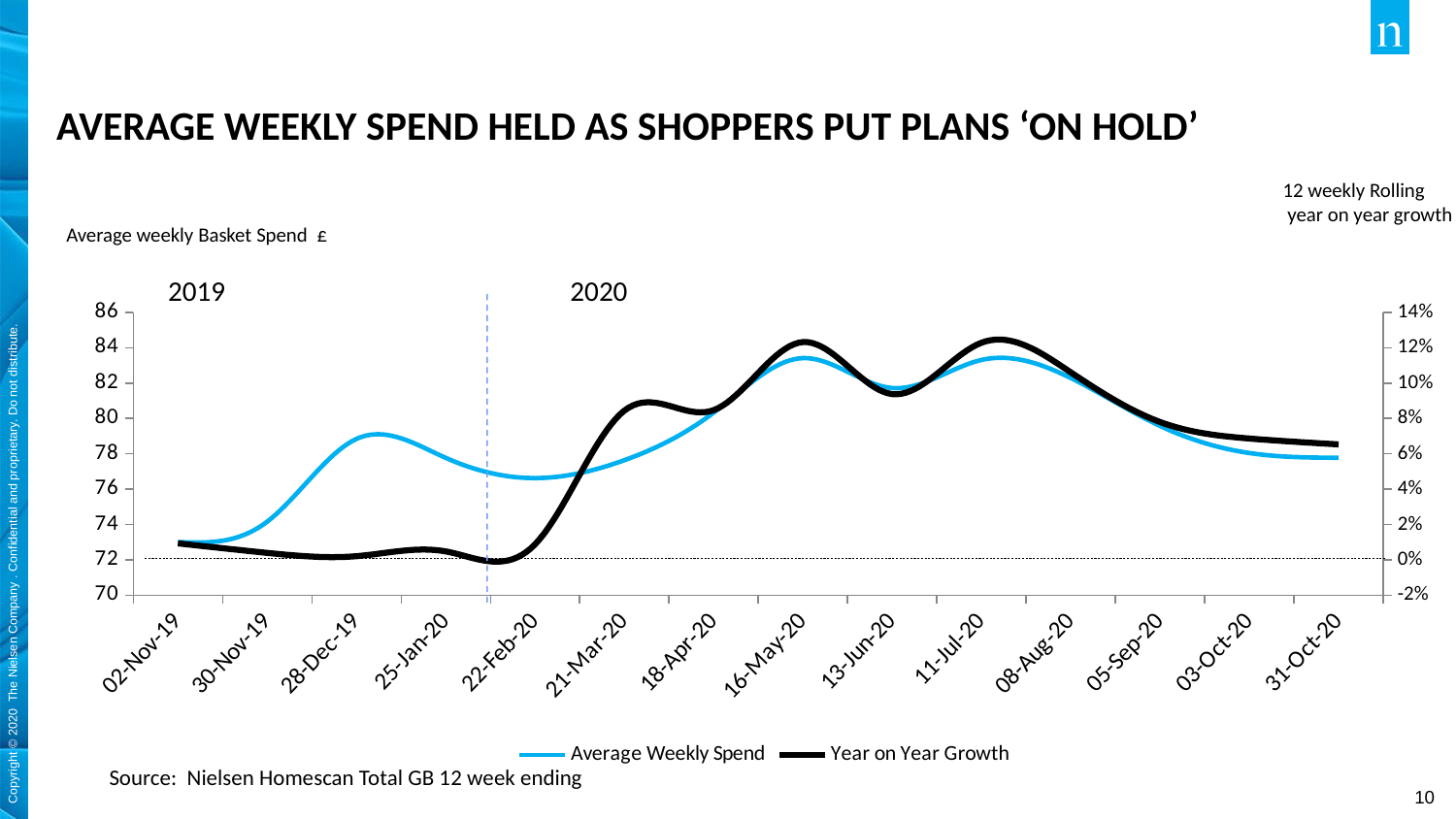
Is the Average Weekly Spend value at 28-Dec-19 greater or less than 76? greater What are the two series named in the legend? Average Weekly Spend and Year on Year Growth Is the Average Weekly Spend value at 02-Nov-19 greater or less than 74? less What kind of chart is shown on the slide? line chart How many date labels are shown on the x axis? 14 Is the Year on Year Growth value at 11-Jul-20 greater or less than 10%? greater What is the title of the slide? AVERAGE WEEKLY SPEND HELD AS SHOPPERS PUT PLANS 'ON HOLD' How many series does the legend list? 2 Does the Year on Year Growth line rise or fall between 22-Feb-20 and 16-May-20? rise Is the Average Weekly Spend higher at 28-Dec-19 or at 22-Feb-20? 28-Dec-19